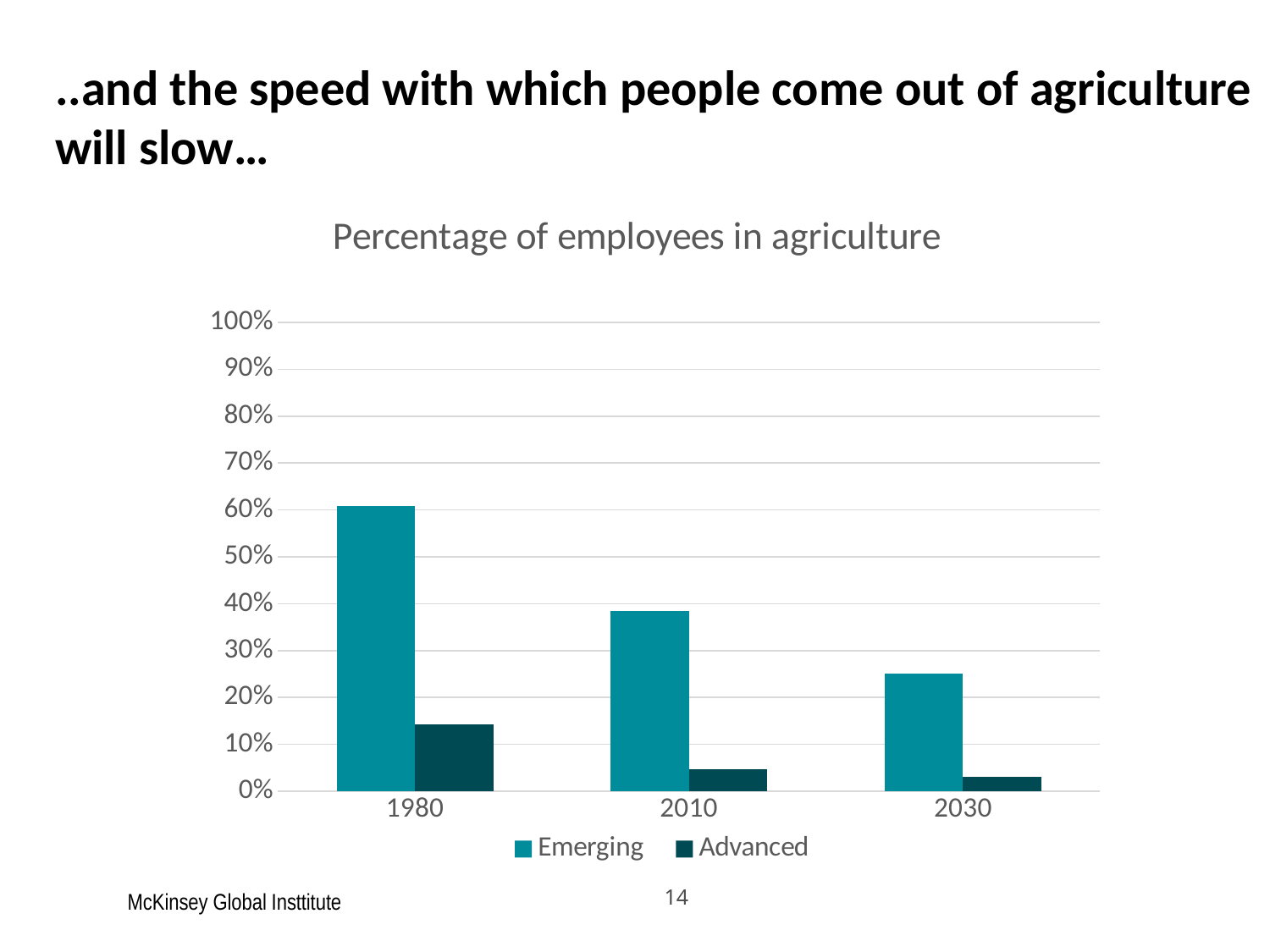
Is the value for Emerging in 2030 greater or less than 30%? less Which year has the lowest value for Emerging? 2030 How many series does the legend list? 2 Is the value for Advanced in 1980 greater or less than 10%? greater Do the values for Emerging rise or fall from 1980 to 2030? fall Which is larger in 2010, the value for Emerging or the value for Advanced? Emerging How many years are shown on the x axis? 3 Which year has the highest value for Emerging? 1980 Is the value for Emerging in 1980 greater or less than 50%? greater What is the title of the chart? Percentage of employees in agriculture What kind of chart is shown on the slide? bar chart Which year has the highest value for Advanced? 1980